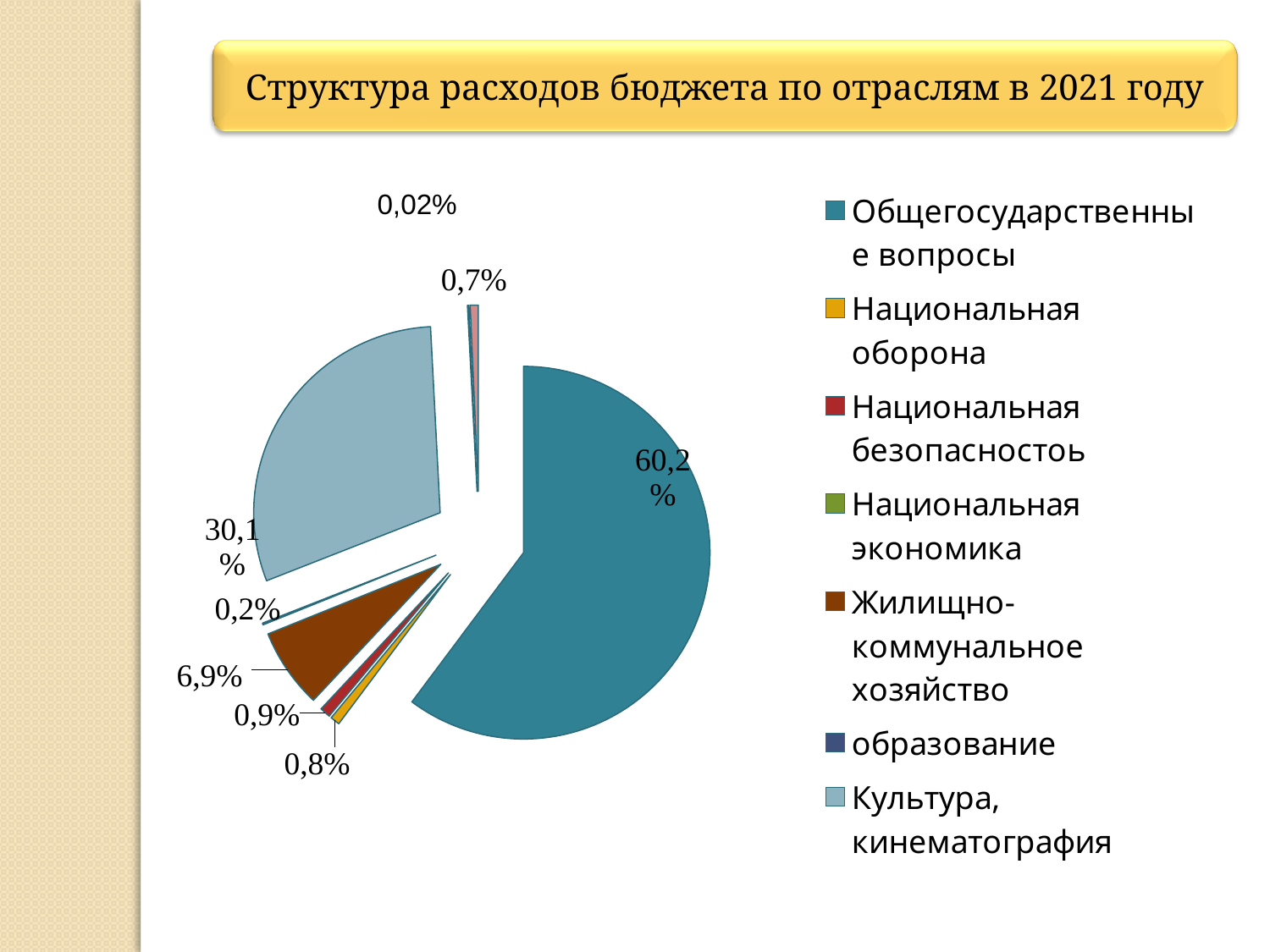
Which category has the largest slice of the pie? Общегосударственные вопросы What is the difference between the shares of Общегосударственные вопросы and Культура, кинематография? 30,1% What type of chart is shown on the slide? pie chart How many entries does the legend list? 7 What is the smallest percentage labelled on the pie? 0,02% What share of the pie is Культура, кинематография? 30,1% What share of the pie is Жилищно-коммунальное хозяйство? 6,9% What colour is the slice for Общегосударственные вопросы? teal Is the share of Общегосударственные вопросы greater or less than 50%? greater What is the title of the chart? Структура расходов бюджета по отраслям в 2021 году What share of the pie is Общегосударственные вопросы? 60,2% Which is larger: the share of Культура, кинематография or the share of Жилищно-коммунальное хозяйство? Культура, кинематография